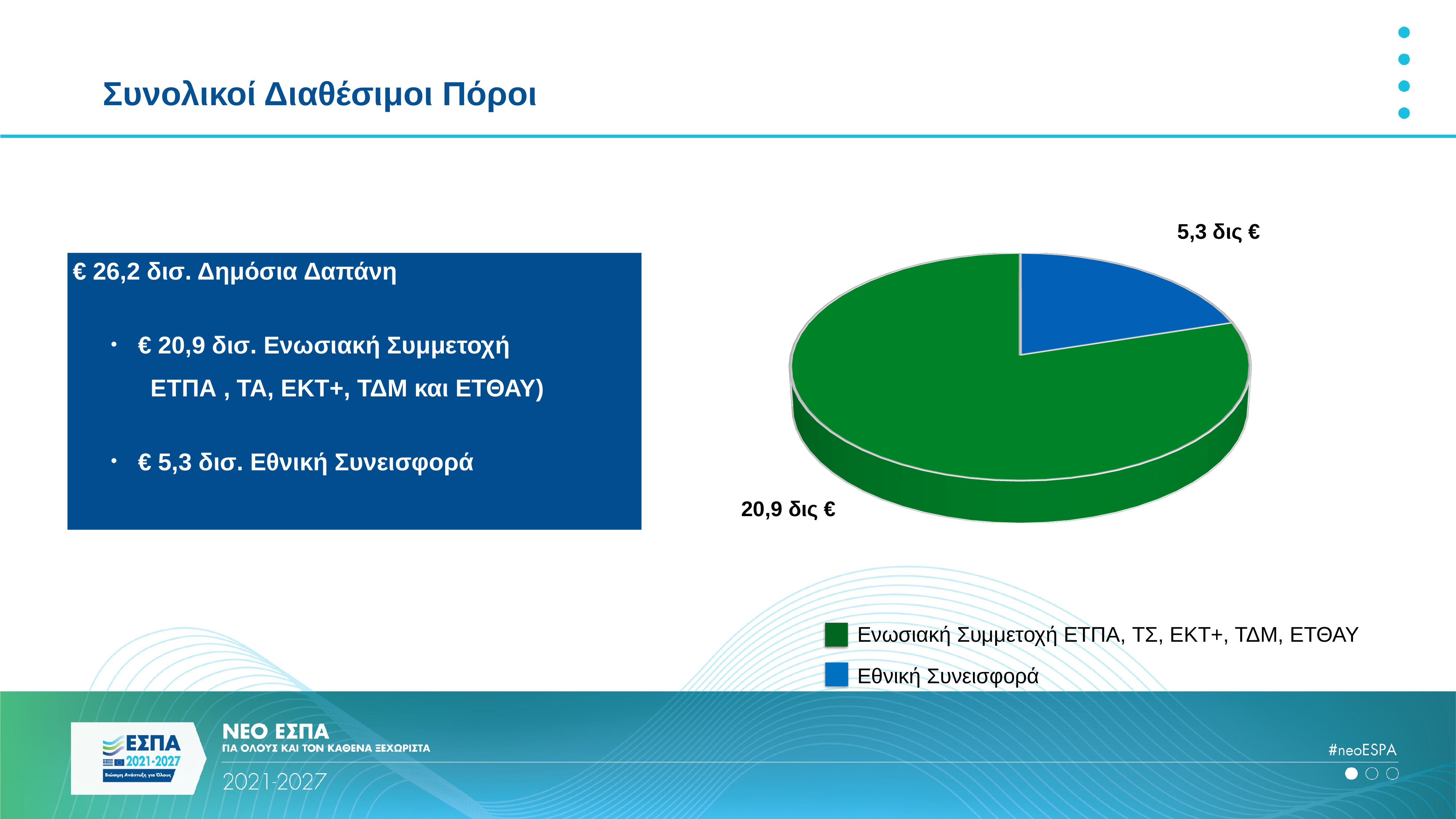
What colour is the Ενωσιακή Συμμετοχή ΕΤΠΑ, ΤΣ, ΕΚΤ+, ΤΔΜ, ΕΤΘΑΥ slice in the pie chart? Green How many entries does the legend of the pie chart list? 2 Which slice of the pie chart is the largest? Ενωσιακή Συμμετοχή ΕΤΠΑ, ΤΣ, ΕΚΤ+, ΤΔΜ, ΕΤΘΑΥ What is the value of the Ενωσιακή Συμμετοχή ΕΤΠΑ, ΤΣ, ΕΚΤ+, ΤΔΜ, ΕΤΘΑΥ slice in the pie chart? 20,9 δις € What is the total of the two slices in the pie chart? 26,2 δις € What kind of chart is shown on the slide? Pie chart Which slice of the pie chart is the smallest? Εθνική Συνεισφορά Which is larger in the pie chart: Ενωσιακή Συμμετοχή or Εθνική Συνεισφορά? Ενωσιακή Συμμετοχή What is the difference between the Ενωσιακή Συμμετοχή slice and the Εθνική Συνεισφορά slice in the pie chart? 15,6 δις € How many slices does the pie chart have? 2 What colour is the Εθνική Συνεισφορά slice in the pie chart? Blue What is the value of the Εθνική Συνεισφορά slice in the pie chart? 5,3 δις €